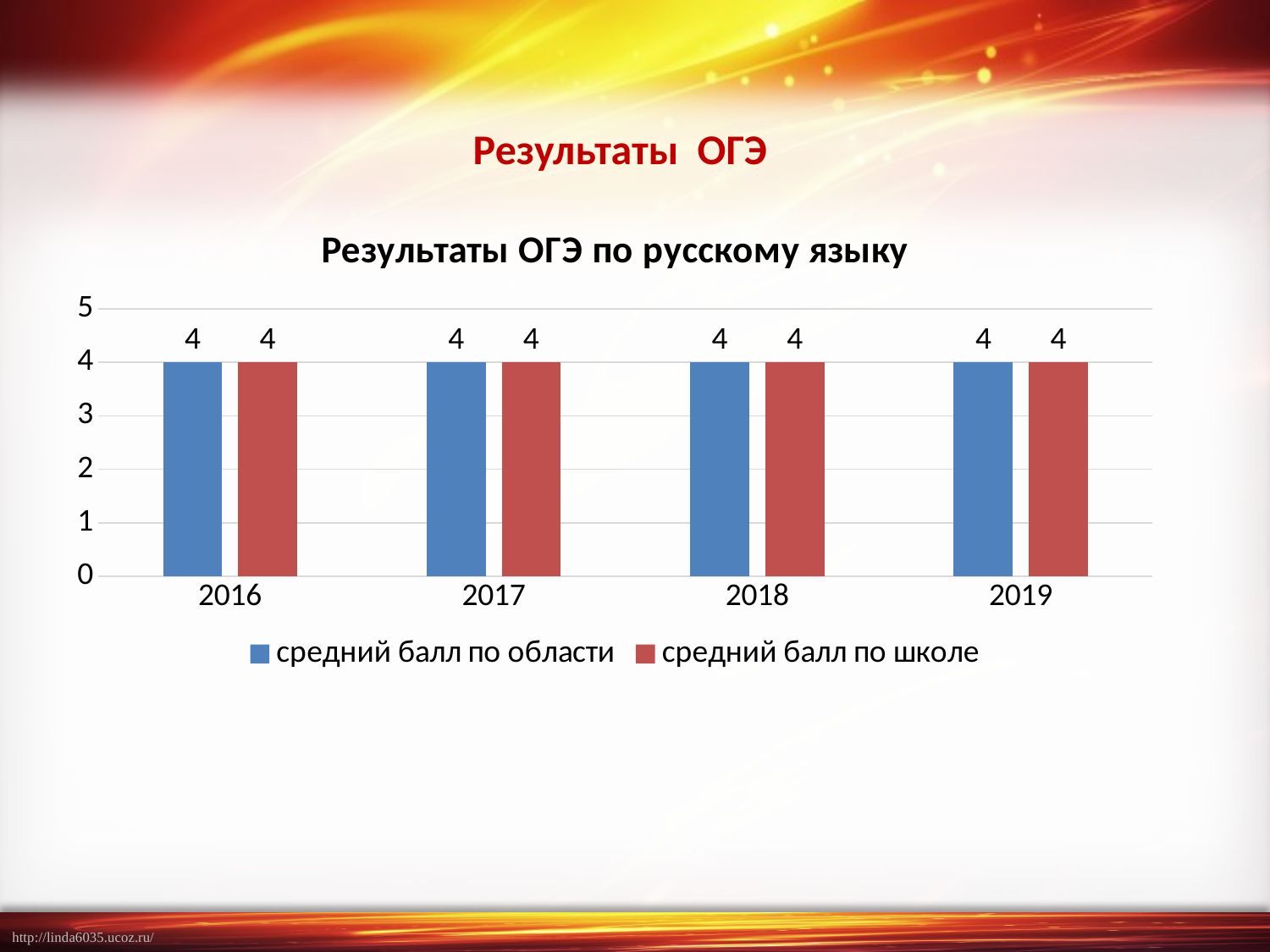
Which colour represents 'средний балл по школе' in the legend? red What kind of chart is shown? bar chart How many years are shown on the x axis? 4 What is the difference between 'средний балл по области' and 'средний балл по школе' in 2018? 0 Is the value for 'средний балл по школе' in 2016 greater or less than 5? less What is the value for 'средний балл по школе' in 2017? 4 What is the value for 'средний балл по области' in 2016? 4 Do the values for 'средний балл по школе' rise, fall, or stay the same from 2016 to 2019? stay the same Is the value for 'средний балл по области' in 2017 greater or less than 3? greater How many series does the legend list? 2 What is the value for 'средний балл по школе' in 2019? 4 What is the title of the chart? Результаты ОГЭ по русскому языку